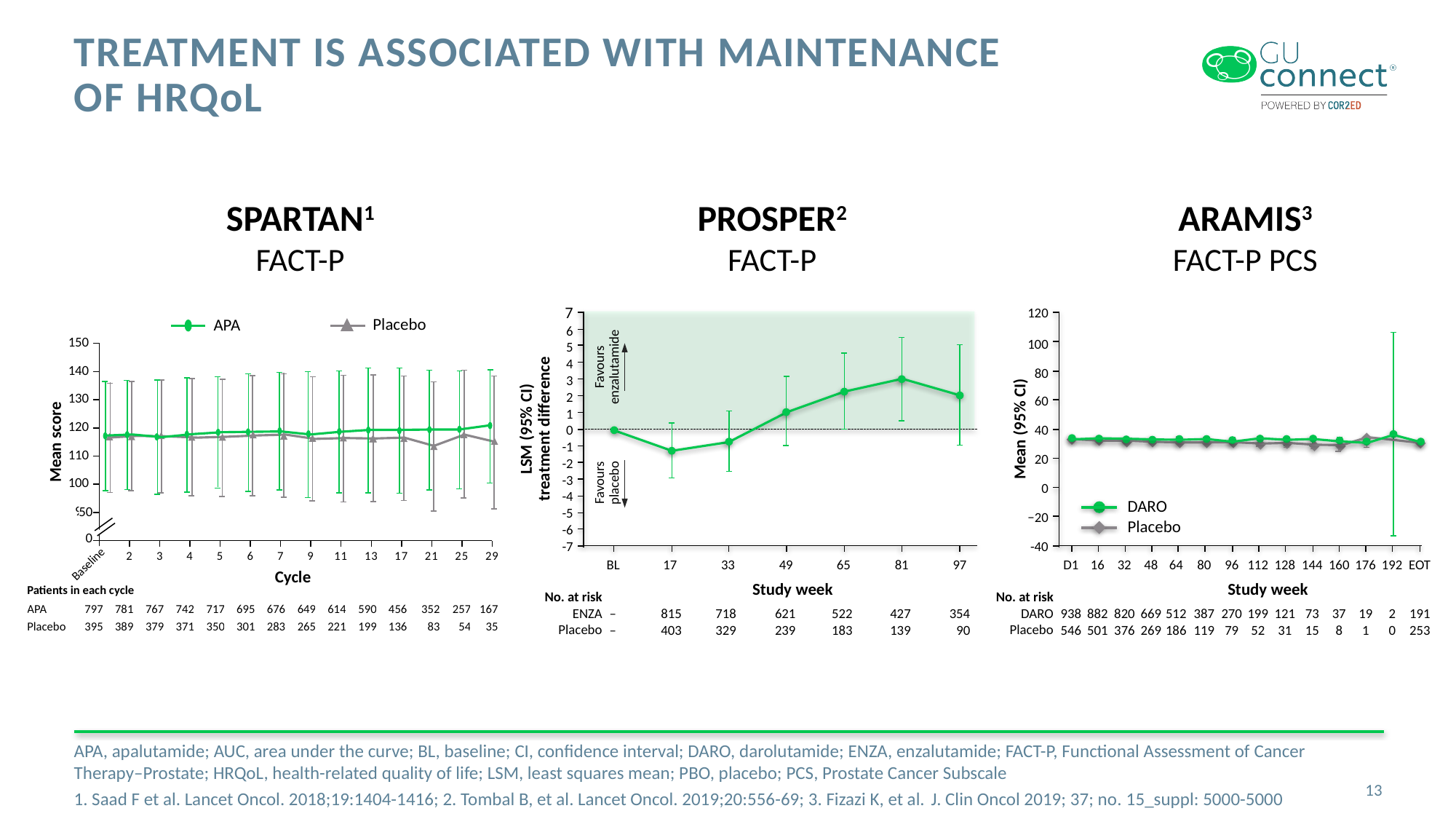
In the PROSPER FACT-P chart, what is the number at risk for ENZA at study week 49? 621 In the PROSPER FACT-P chart, does the LSM treatment difference rise or fall from study week 17 to study week 81? rise In the SPARTAN FACT-P chart, is the APA mean score at cycle 29 greater or less than 100? greater How many series does the legend of the SPARTAN FACT-P chart list? 2 In the ARAMIS FACT-P PCS chart, what is the number at risk for DARO at D1? 938 How many series does the legend of the ARAMIS FACT-P PCS chart list? 2 In the PROSPER FACT-P chart, is the LSM treatment difference at study week 81 greater or less than 0? greater In the SPARTAN FACT-P chart, how many APA patients are in cycle 29? 167 In the PROSPER FACT-P chart, is the LSM treatment difference at study week 17 greater or less than 0? less How many study week points are shown on the x axis of the PROSPER FACT-P chart? 7 What kind of chart is the SPARTAN FACT-P chart? line chart